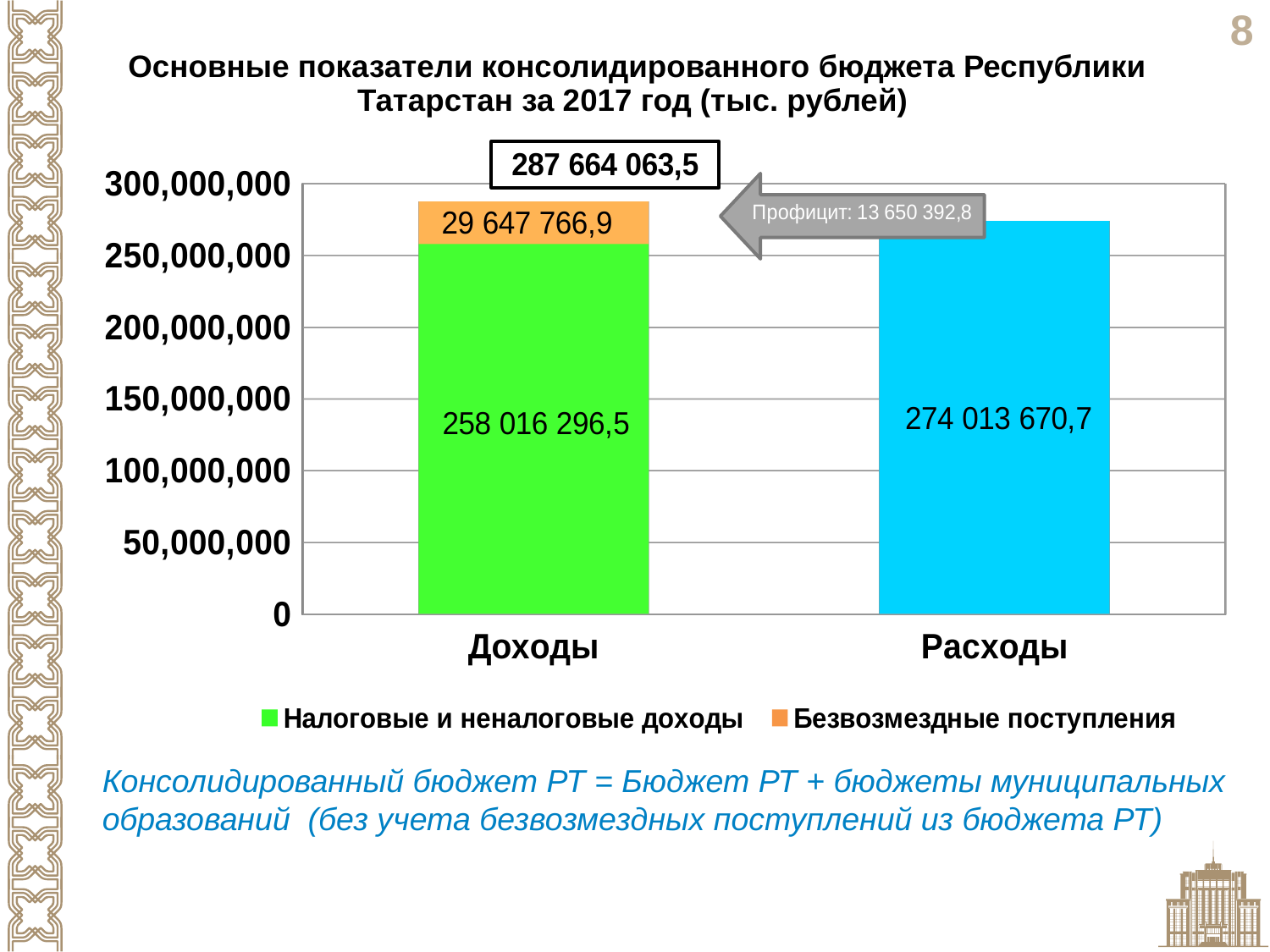
How many categories are shown on the x axis? 2 What kind of chart is shown on the slide? bar chart What colour represents Безвозмездные поступления in the chart? orange Which is larger, the total for Доходы or the value for Расходы? Доходы What is the value of Налоговые и неналоговые доходы in the Доходы bar? 258 016 296,5 What is the total of the stacked Доходы bar? 287 664 063,5 What is the value shown for Расходы? 274 013 670,7 By how much does the total for Доходы exceed the value for Расходы? 13 650 392,8 What is the value of Безвозмездные поступления in the Доходы bar? 29 647 766,9 How many series does the legend list? 2 Is the value for Расходы greater or less than 250,000,000? greater What is the difference between Налоговые и неналоговые доходы and Безвозмездные поступления in the Доходы bar? 228 368 529,6